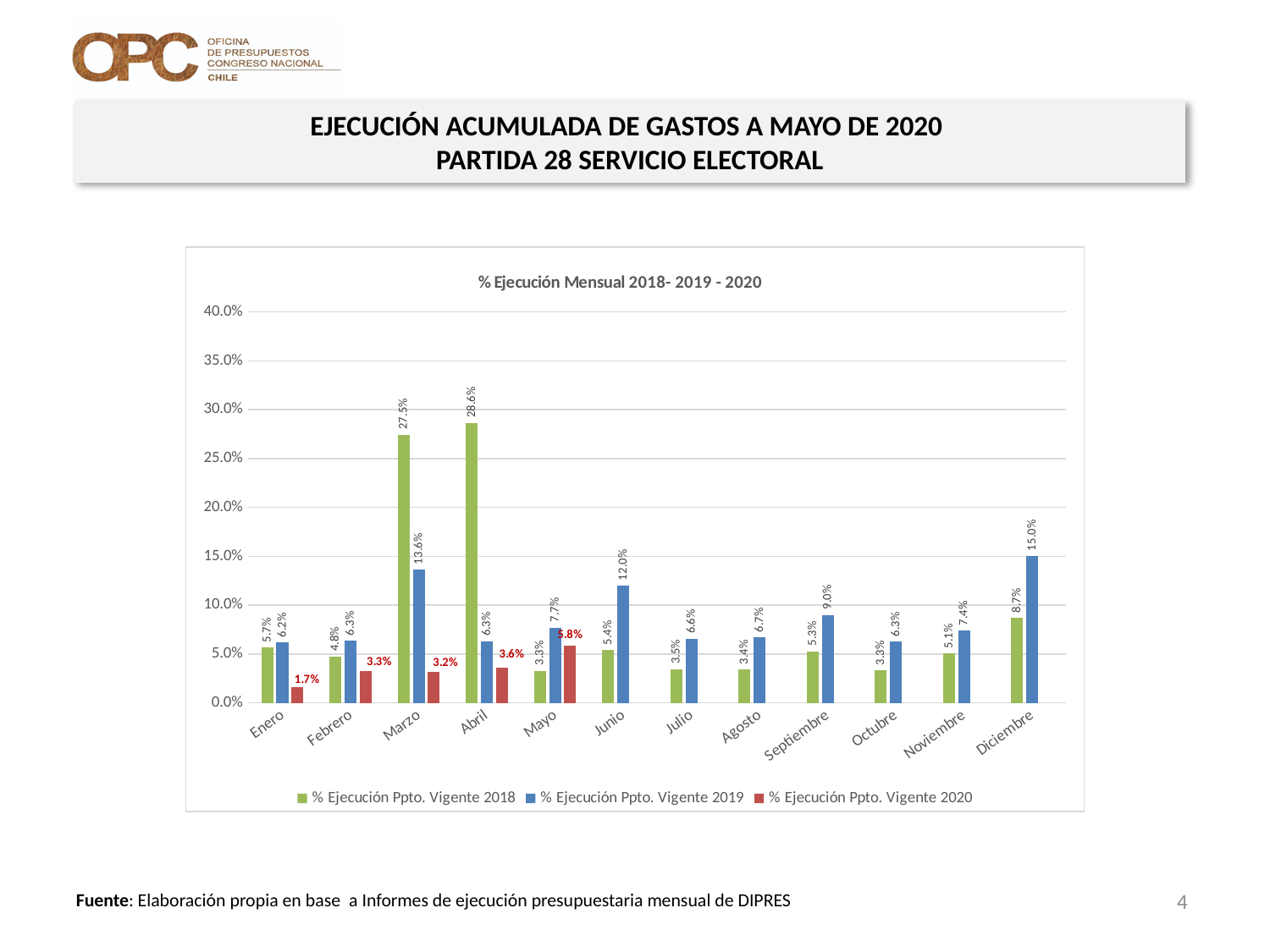
In Mayo, which series has the larger value: % Ejecución Ppto. Vigente 2018 or % Ejecución Ppto. Vigente 2019? % Ejecución Ppto. Vigente 2019 In which month is the % Ejecución Ppto. Vigente 2020 series lowest? Enero What is the value for % Ejecución Ppto. Vigente 2018 in Abril? 28.6% Does the % Ejecución Ppto. Vigente 2020 series rise or fall from Enero to Febrero? Rise How many months are shown on the x axis? 12 What is the value for % Ejecución Ppto. Vigente 2020 in Enero? 1.7% What is the title of the chart? % Ejecución Mensual 2018- 2019 - 2020 What is the value for % Ejecución Ppto. Vigente 2019 in Diciembre? 15.0% What is the difference between the 2018 and 2019 values in Marzo? 13.9% How many series does the legend list? 3 In which month is the % Ejecución Ppto. Vigente 2018 series highest? Abril What kind of chart is shown on the slide? Bar chart